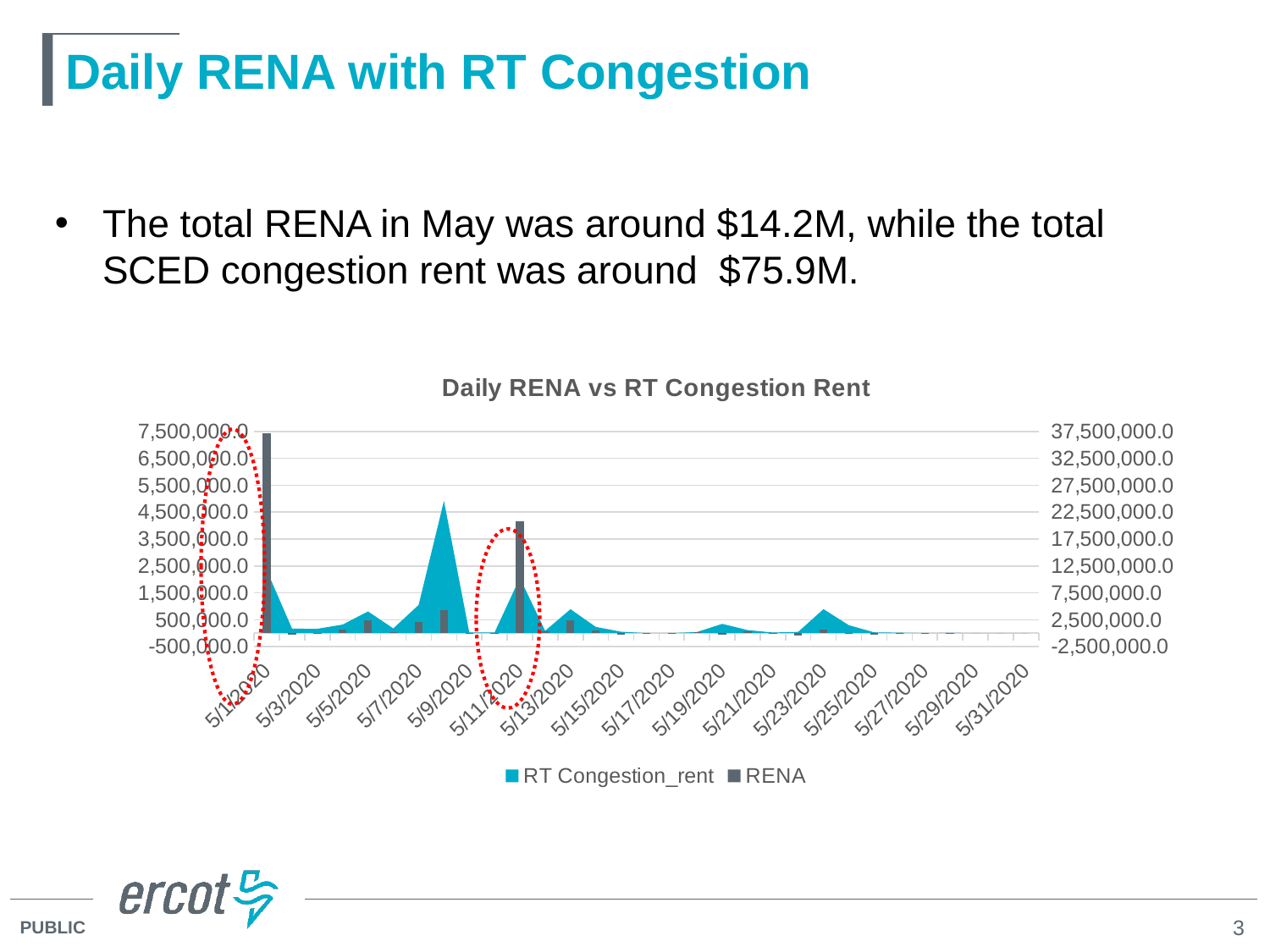
Which date has the larger RENA bar, 5/1/2020 or 5/11/2020? 5/1/2020 What is the title of the chart? Daily RENA vs RT Congestion Rent What kind of chart is used to show the RENA series? Bar chart Are the RENA and RT Congestion_rent values generally higher at the start or at the end of May? At the start On which date is the RENA bar the highest? 5/1/2020 Is the RENA value for 5/11/2020 greater or less than 2,500,000.0? greater Which date has the larger RT Congestion_rent value, 5/9/2020 or 5/23/2020? 5/23/2020 Is the RENA value for 5/1/2020 greater or less than 5,500,000.0? greater What are the two series named in the chart legend? RT Congestion_rent and RENA How many series does the chart legend list? 2 How many date labels are shown on the x axis? 16